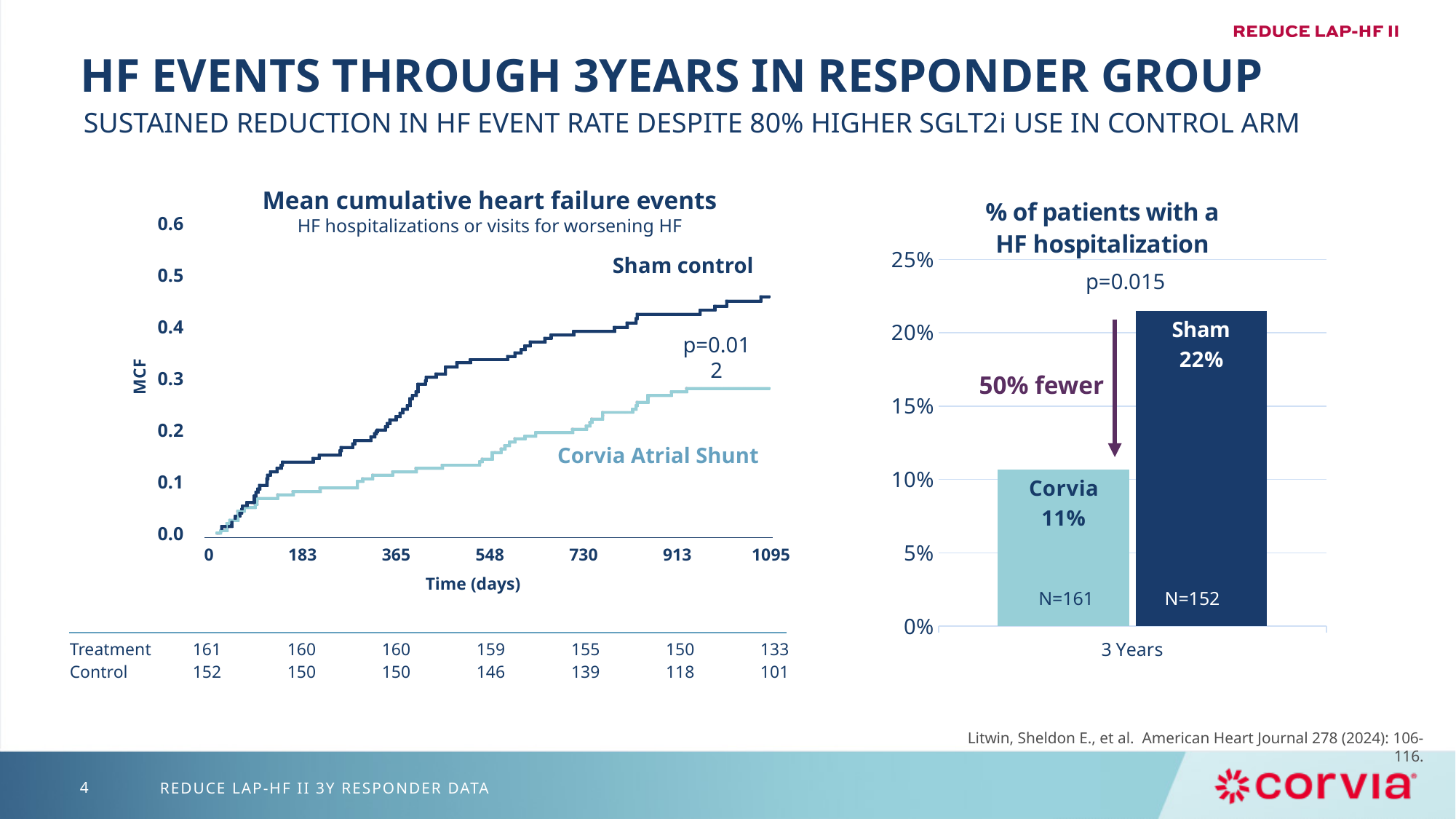
What kind of chart is the '% of patients with a HF hospitalization' chart? bar chart In the 'Mean cumulative heart failure events' chart, do the curves rise or fall as time increases? rise In the 'Mean cumulative heart failure events' chart, is the Corvia Atrial Shunt value at 1095 days greater or less than 0.3? less In the '% of patients with a HF hospitalization' chart, what is the value for Corvia? 11% In the 'Mean cumulative heart failure events' chart, is the Sham control value at 1095 days greater or less than 0.4? greater In the '% of patients with a HF hospitalization' chart, what is the difference between the Sham and Corvia percentages? 11% In the '% of patients with a HF hospitalization' chart, which group has the higher percentage? Sham In the 'Mean cumulative heart failure events' chart, which curve is higher at 730 days, Sham control or Corvia Atrial Shunt? Sham control In the '% of patients with a HF hospitalization' chart, what is the N for the Corvia bar? N=161 In the '% of patients with a HF hospitalization' chart, what is the value for Sham? 22% In the '% of patients with a HF hospitalization' chart, how many bars are shown? 2 In the '% of patients with a HF hospitalization' chart, what p-value is shown? p=0.015